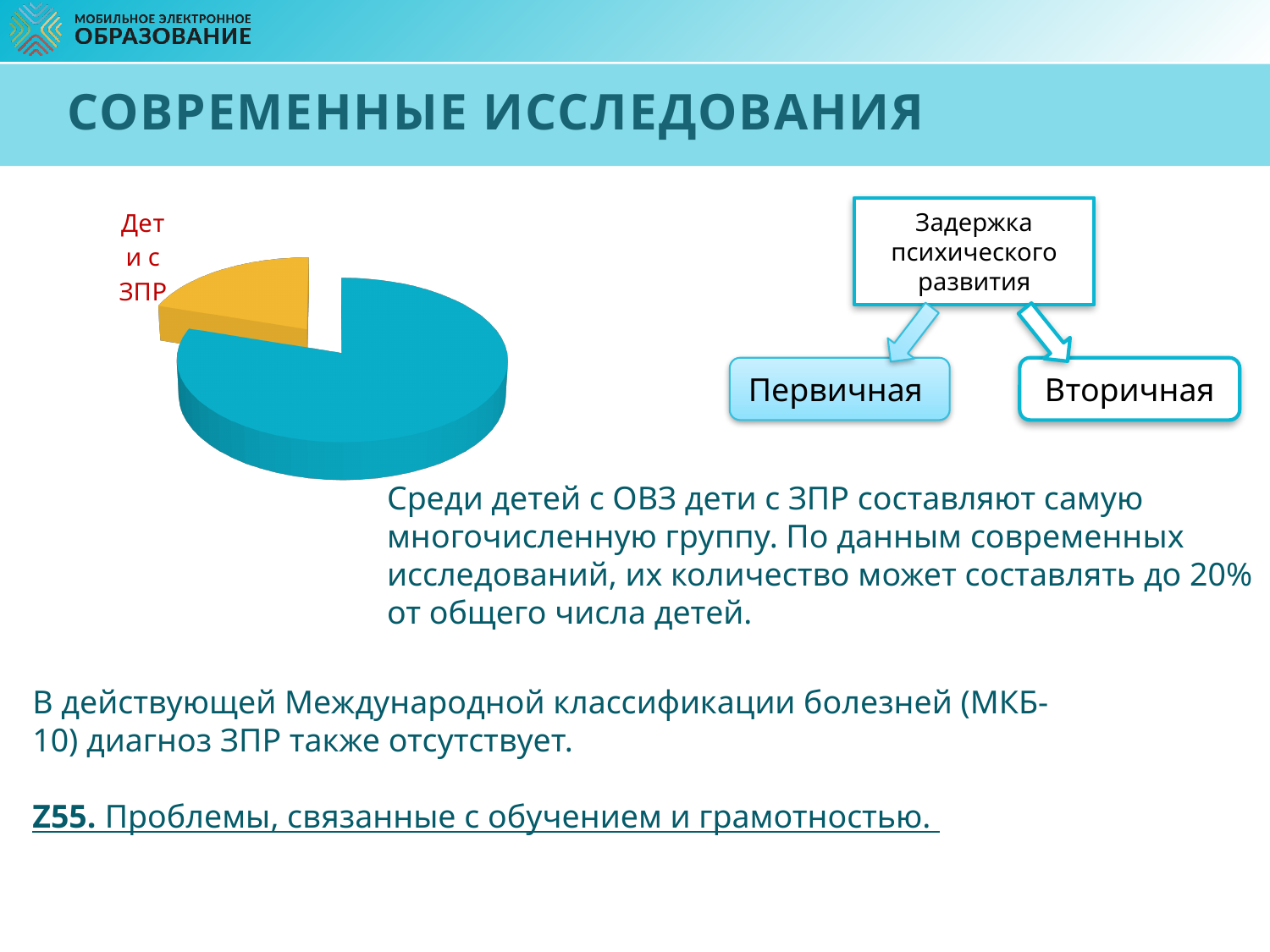
What colour is the slice labelled "Дети с ЗПР" in the pie chart? yellow Which slice of the pie chart is larger, the teal slice or the yellow slice labelled "Дети с ЗПР"? the teal slice What kind of chart is shown on the left of the slide? pie chart Which slice of the pie chart is the smallest? Дети с ЗПР How many slices does the pie chart have? 2 What label is printed next to the yellow slice of the pie chart? Дети с ЗПР